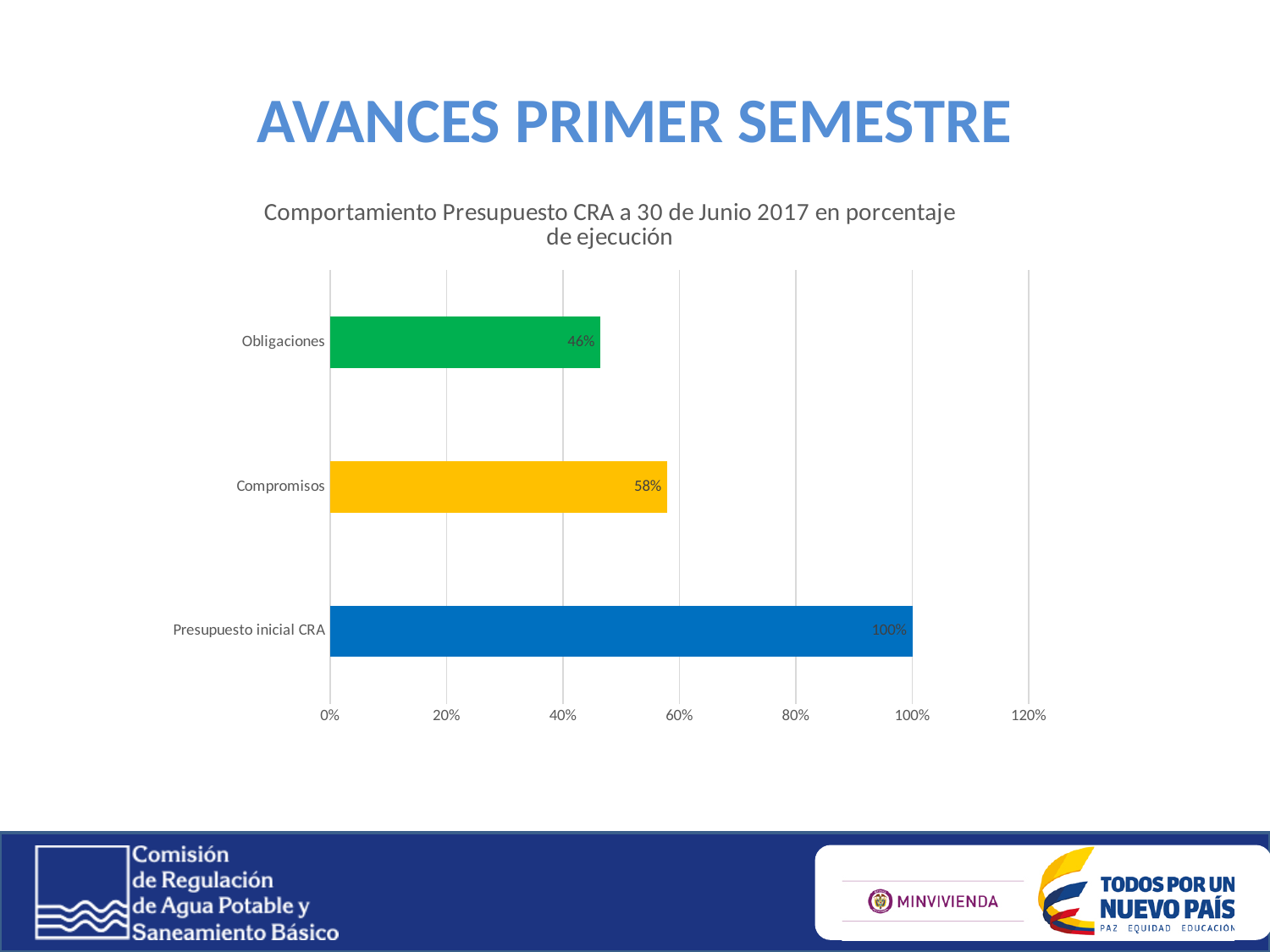
Which category has the lowest value? Obligaciones What is the value for Obligaciones? 46% Is the value for Obligaciones greater or less than 60%? less How many categories are shown in the chart? 3 What kind of chart is shown on the slide? bar chart What is the title of the chart? Comportamiento Presupuesto CRA a 30 de Junio 2017 en porcentaje de ejecución What is the value for Presupuesto inicial CRA? 100% Which category has the highest value? Presupuesto inicial CRA Which is larger, the value for Compromisos or the value for Obligaciones? Compromisos What is the difference between the values for Presupuesto inicial CRA and Compromisos? 42% What is the value for Compromisos? 58% What is the difference between the values for Compromisos and Obligaciones? 12%